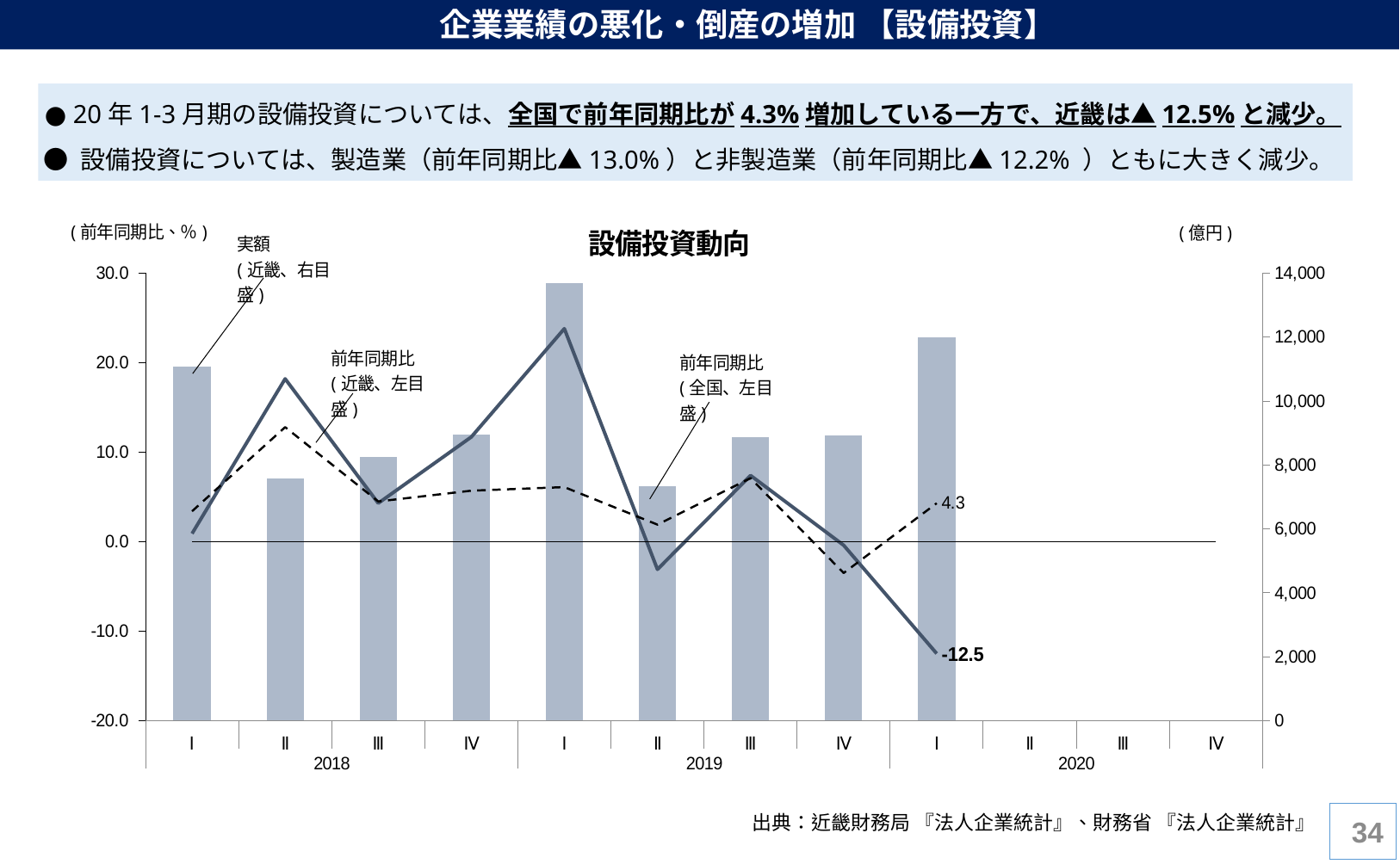
What is the 前年同期比 value for 近畿 in 2020 I? -12.5 What is the title of the chart? 設備投資動向 What is the 前年同期比 value for 全国 in 2020 I? 4.3 Is the 近畿 前年同期比 value for 2019 I greater or less than 20.0? greater Is the 実額 bar for 2019 I greater or less than 12,000? greater What is the difference between the 全国 and 近畿 前年同期比 values in 2020 I? 16.8 How many quarters have a 実額 bar plotted? 9 Is the 実額 bar for 2018 I greater or less than 10,000? greater Does the 近畿 前年同期比 line rise or fall from 2019 III to 2020 I? fall What kind of chart is shown on the slide? Combined bar and line chart In 2020 I, which 前年同期比 value is larger, 近畿 or 全国? 全国 In which quarter is the 実額 (近畿) bar the highest? 2019 I